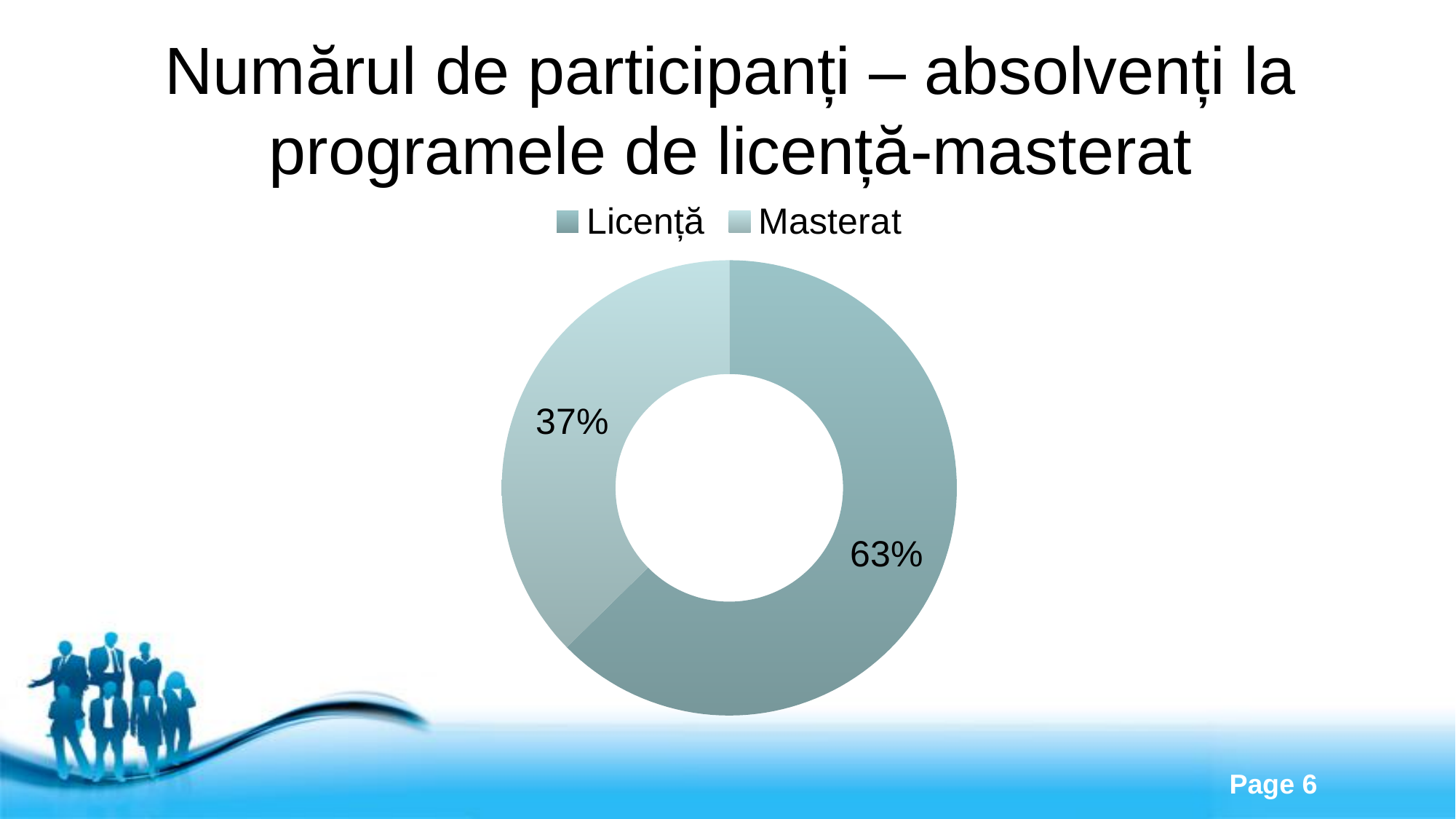
Which category has the smallest share of the chart? Masterat What is the difference in percentage points between the Licență and Masterat shares? 26% What is the title of the slide containing the chart? Numărul de participanți – absolvenți la programele de licență-masterat Which legend entry is listed first? Licență Which is larger, the Licență share or the Masterat share? Licență How many categories are shown in the chart? 2 What share of participants does the Masterat slice represent? 37% What kind of chart is shown on the slide? Doughnut (pie) chart Which category has the largest share of the chart? Licență How many entries does the legend list? 2 Is the Masterat share greater or less than 50%? less What share of participants does the Licență slice represent? 63%